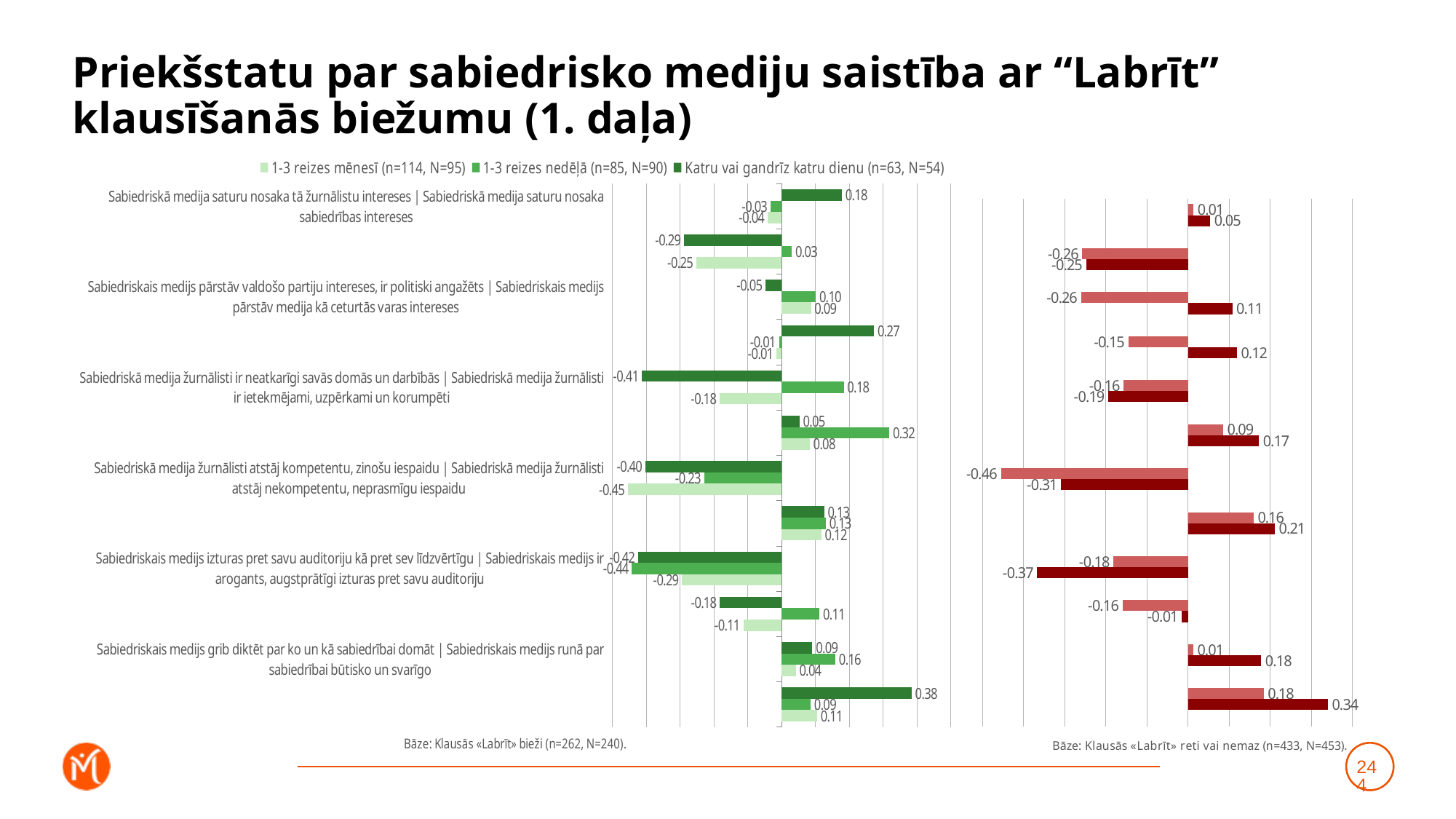
In the right (red) chart, what is the highest value printed on any bar? 0.34 In the left (green) chart, what is the value of the 'Katru vai gandrīz katru dienu' series for the first category 'Sabiedriskā medija saturu nosaka tā žurnālistu intereses | Sabiedriskā medija saturu nosaka sabiedrības intereses'? 0.18 In the left (green) chart, what is the highest value printed on any bar? 0.38 In the left (green) chart, what is the value of the '1-3 reizes mēnesī' series for the first category 'Sabiedriskā medija saturu nosaka tā žurnālistu intereses | Sabiedriskā medija saturu nosaka sabiedrības intereses'? -0.04 In the left (green) chart, for the first category, which series has the larger value: 'Katru vai gandrīz katru dienu' or '1-3 reizes mēnesī'? Katru vai gandrīz katru dienu What sample sizes does the legend give for the '1-3 reizes mēnesī' series in the left chart? n=114, N=95 What base note is printed under the right (red) chart? Bāze: Klausās «Labrīt» reti vai nemaz (n=433, N=453). What kind of chart is shown on the left side of the slide? bar chart In the left (green) chart, what is the lowest value printed on any bar? -0.45 In the left (green) chart, what is the difference between the 'Katru vai gandrīz katru dienu' value (0.18) and the '1-3 reizes mēnesī' value (-0.04) for the first category? 0.22 In the right (red) chart, what is the lowest value printed on any bar? -0.46 How many series does the legend of the left (green) chart list? 3